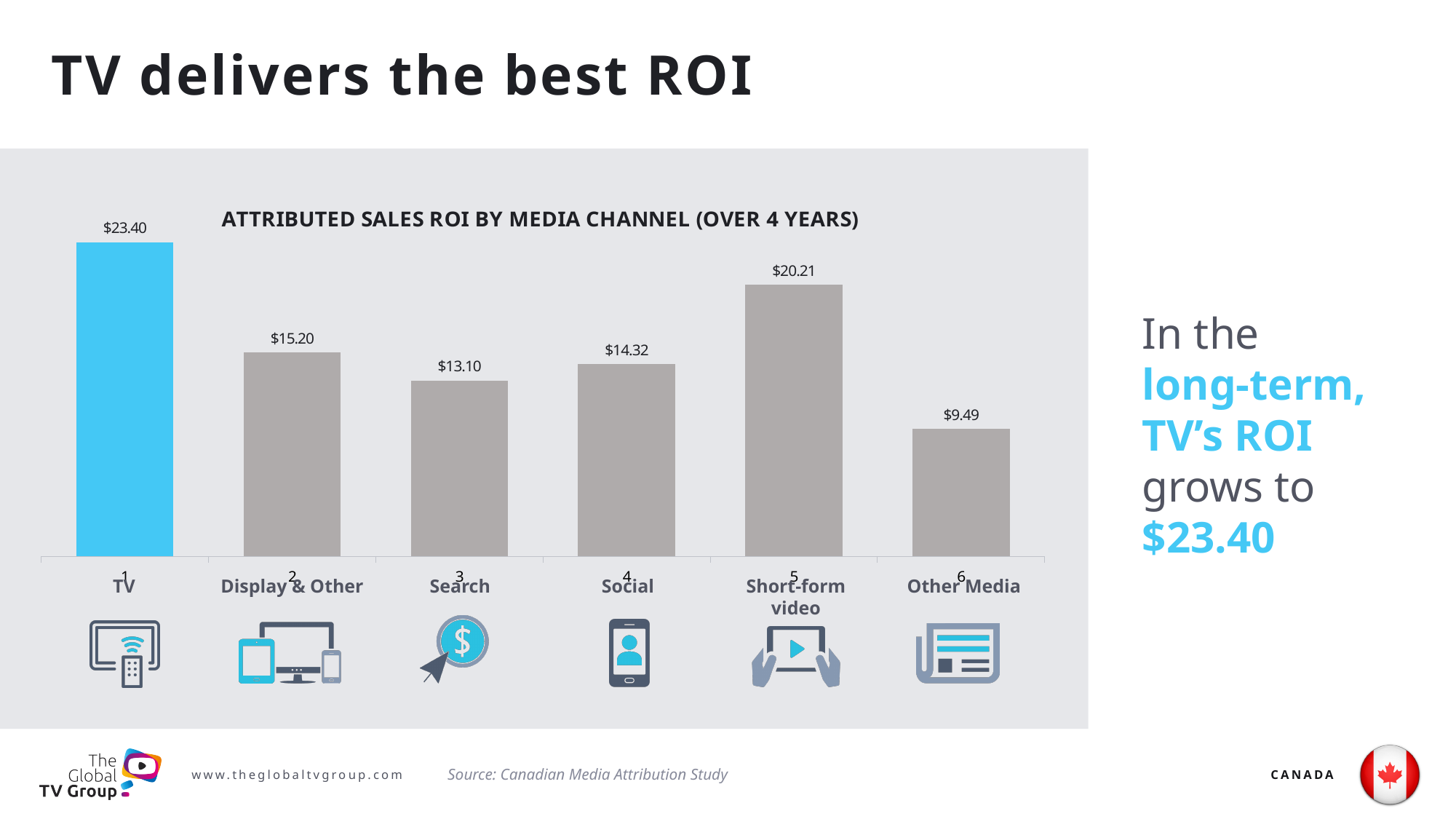
What is the attributed sales ROI for Search? $13.10 What is the difference between the ROI for TV and the ROI for Short-form video? $3.19 Which media channel has the lowest attributed sales ROI? Other Media What is the difference between the ROI for Display & Other and the ROI for Social? $0.88 Which media channel has the highest attributed sales ROI? TV Which has a higher ROI, Social or Search? Social What is the attributed sales ROI for Short-form video? $20.21 What is the title of the chart? ATTRIBUTED SALES ROI BY MEDIA CHANNEL (OVER 4 YEARS) What is the attributed sales ROI for TV? $23.40 How many media channels are shown in the chart? 6 What type of chart is shown on the slide? Bar chart Which bar in the chart is coloured blue rather than grey? TV